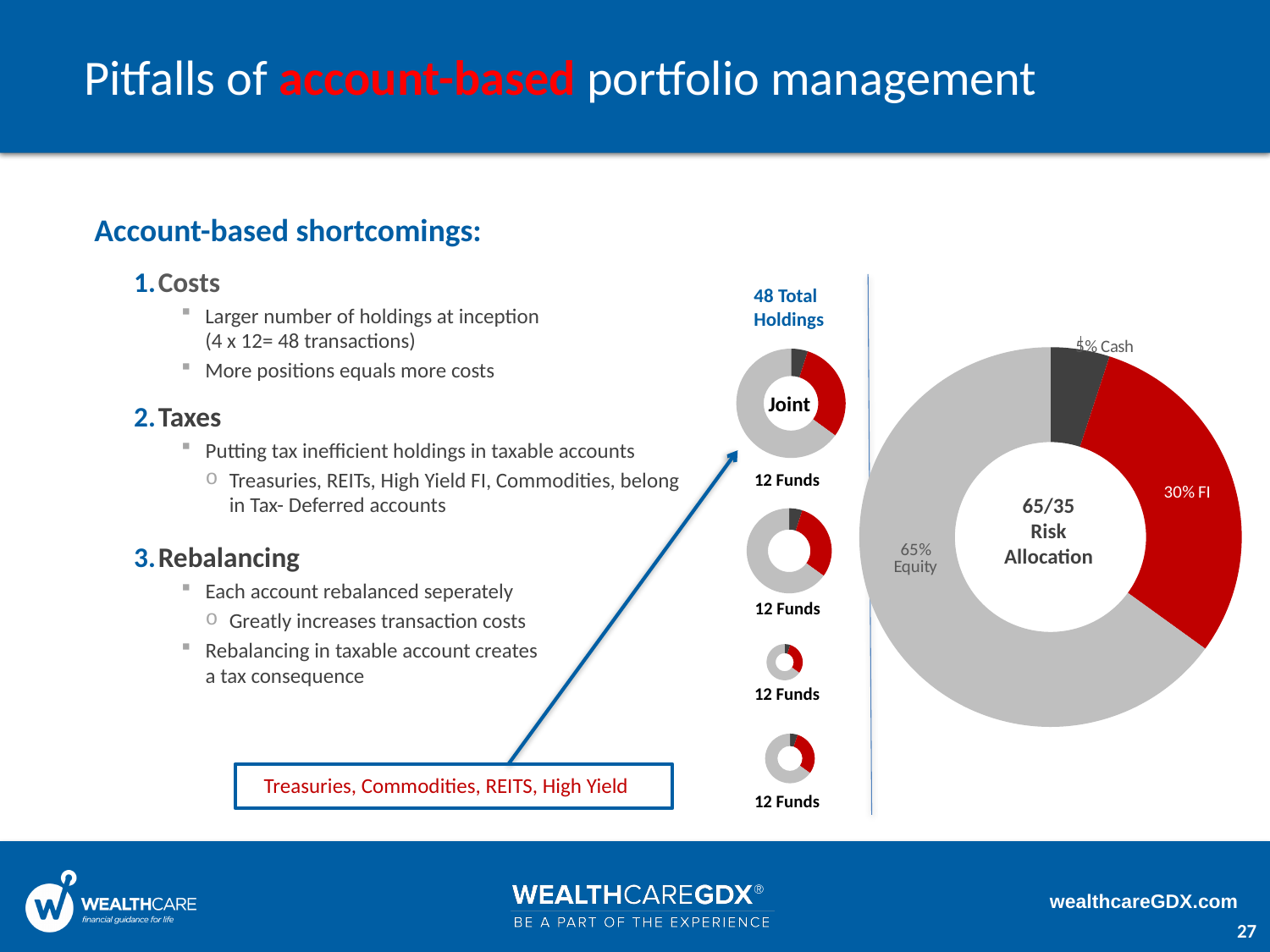
How many small donut charts are shown in the column to the left of the large donut chart? 4 In the large donut chart on the right, what percentage is allocated to Cash? 5% In the large donut chart on the right, which category has the smallest share? Cash In the large donut chart on the right, what percentage is allocated to FI? 30% What kind of chart is the large chart on the right of the slide? Donut (pie) chart In the large donut chart on the right, which is larger, the Equity share or the FI share? Equity What label appears beneath each of the small donut charts? 12 Funds How many slices does the large donut chart on the right have? 3 In the large donut chart on the right, what percentage is allocated to Equity? 65% In the large donut chart on the right, which category has the largest share? Equity What text is shown in the centre of the large donut chart on the right? 65/35 Risk Allocation In the large donut chart on the right, what is the difference in percentage points between Equity and FI? 35 percentage points